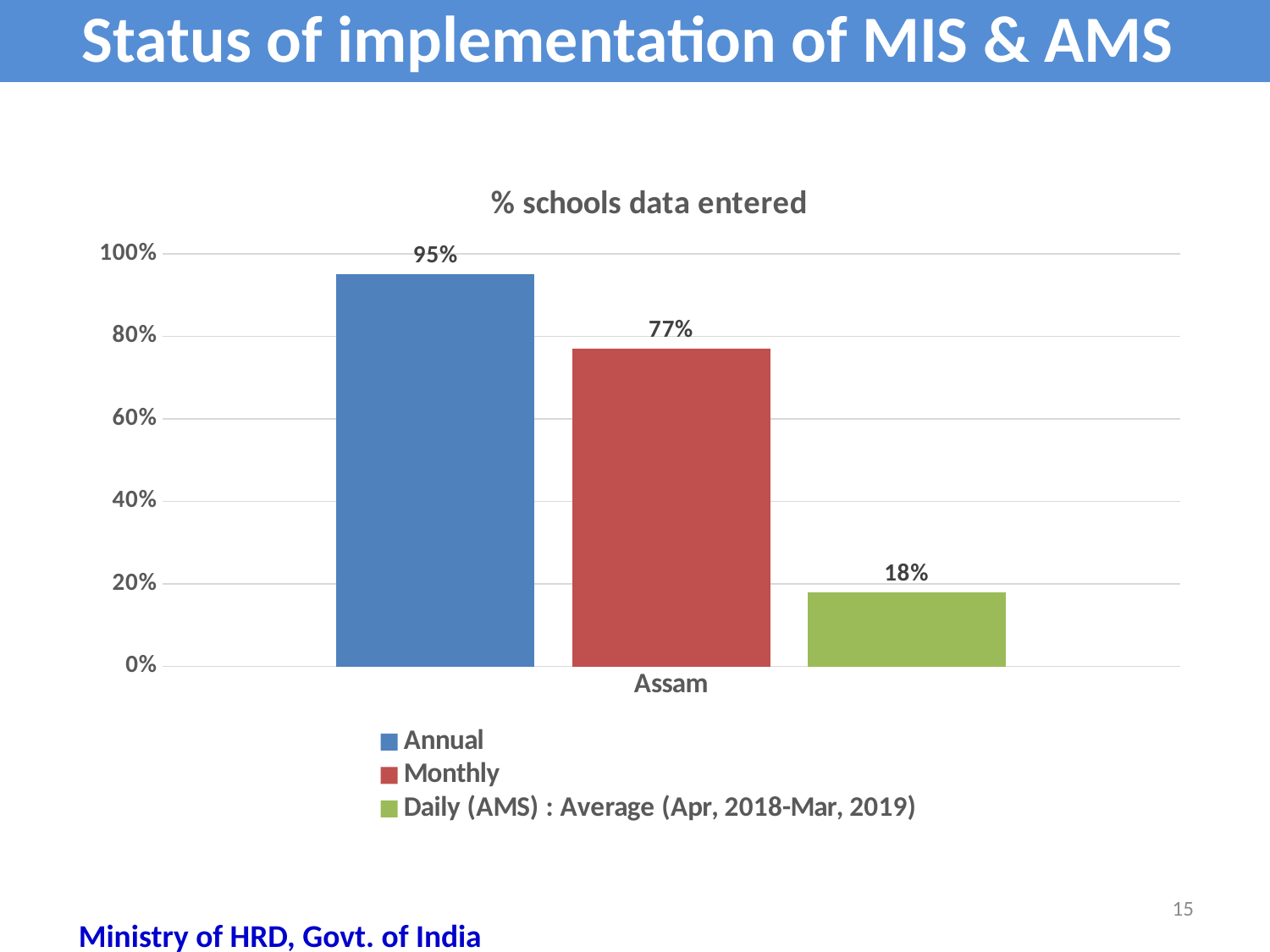
What is the difference between the Monthly and Daily (AMS) values for Assam? 59% Which is larger for Assam, the Monthly value or the Daily (AMS) value? Monthly Which series has the highest value for Assam? Annual What is the difference between the Annual and Monthly values for Assam? 18% How many series does the legend list? 3 What is the value for the Annual series for Assam? 95% Is the Daily (AMS) value for Assam greater or less than 20%? less Which series has the lowest value for Assam? Daily (AMS) : Average (Apr, 2018-Mar, 2019) What is the value for the Monthly series for Assam? 77% What is the value for the Daily (AMS) : Average (Apr, 2018-Mar, 2019) series for Assam? 18% What kind of chart is shown on the slide? bar chart What is the title of the chart? % schools data entered